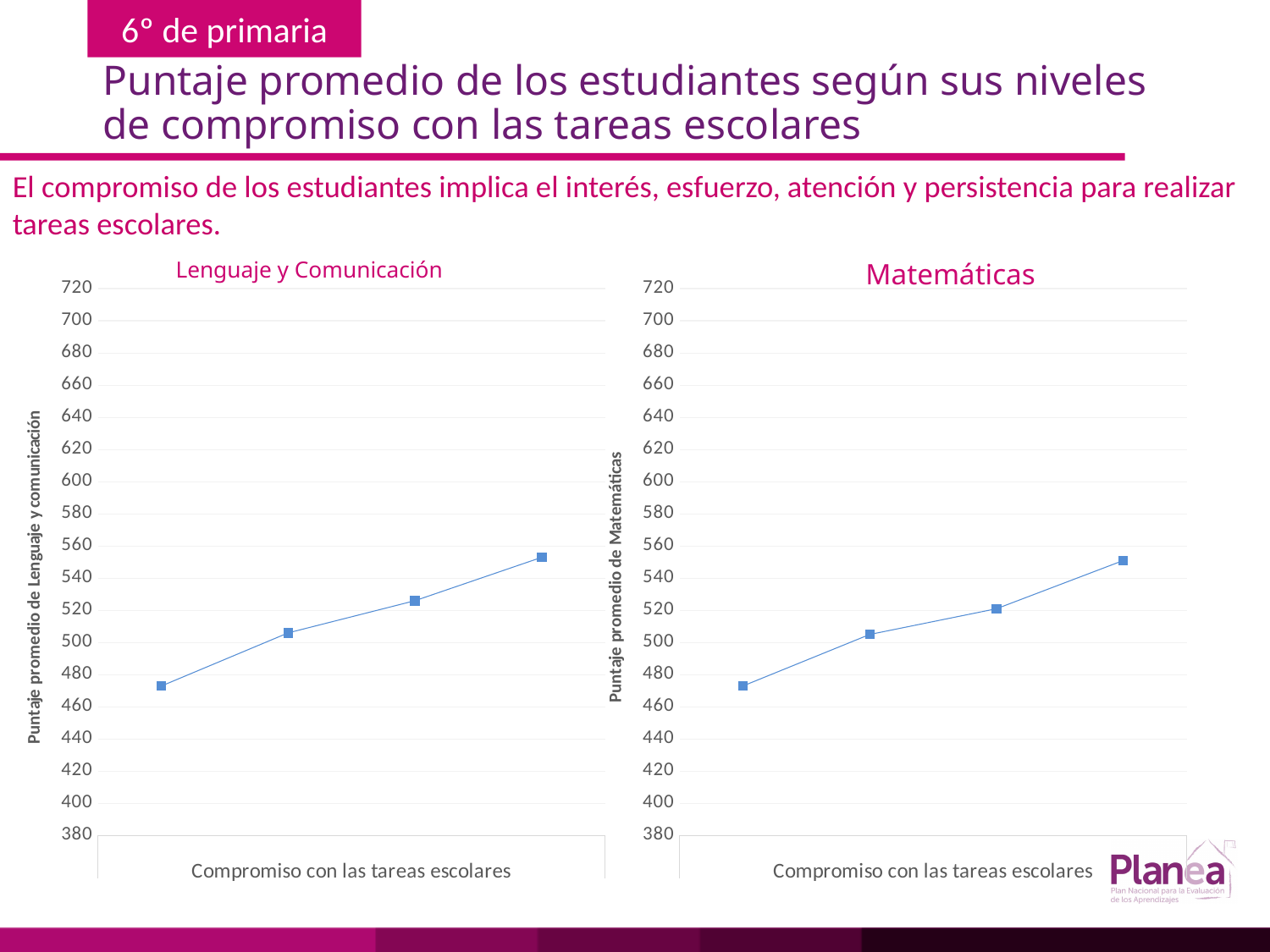
On the Lenguaje y Comunicación chart, do the values rise or fall from left to right along the x axis? rise On the Lenguaje y Comunicación chart, is the value of the first (leftmost) point greater or less than 480? less On the Matemáticas chart, is the value of the first (leftmost) point greater or less than 460? greater What is the y-axis title of the Lenguaje y Comunicación chart? Puntaje promedio de Lenguaje y comunicación On the Matemáticas chart, is the value of the last (rightmost) point greater or less than 540? greater What kind of chart is the Lenguaje y Comunicación chart? line chart On the Matemáticas chart, do the values rise or fall from left to right along the x axis? rise What is the x-axis label on the Matemáticas chart? Compromiso con las tareas escolares How many data points are plotted on the Matemáticas chart? 4 How many data points are plotted on the Lenguaje y Comunicación chart? 4